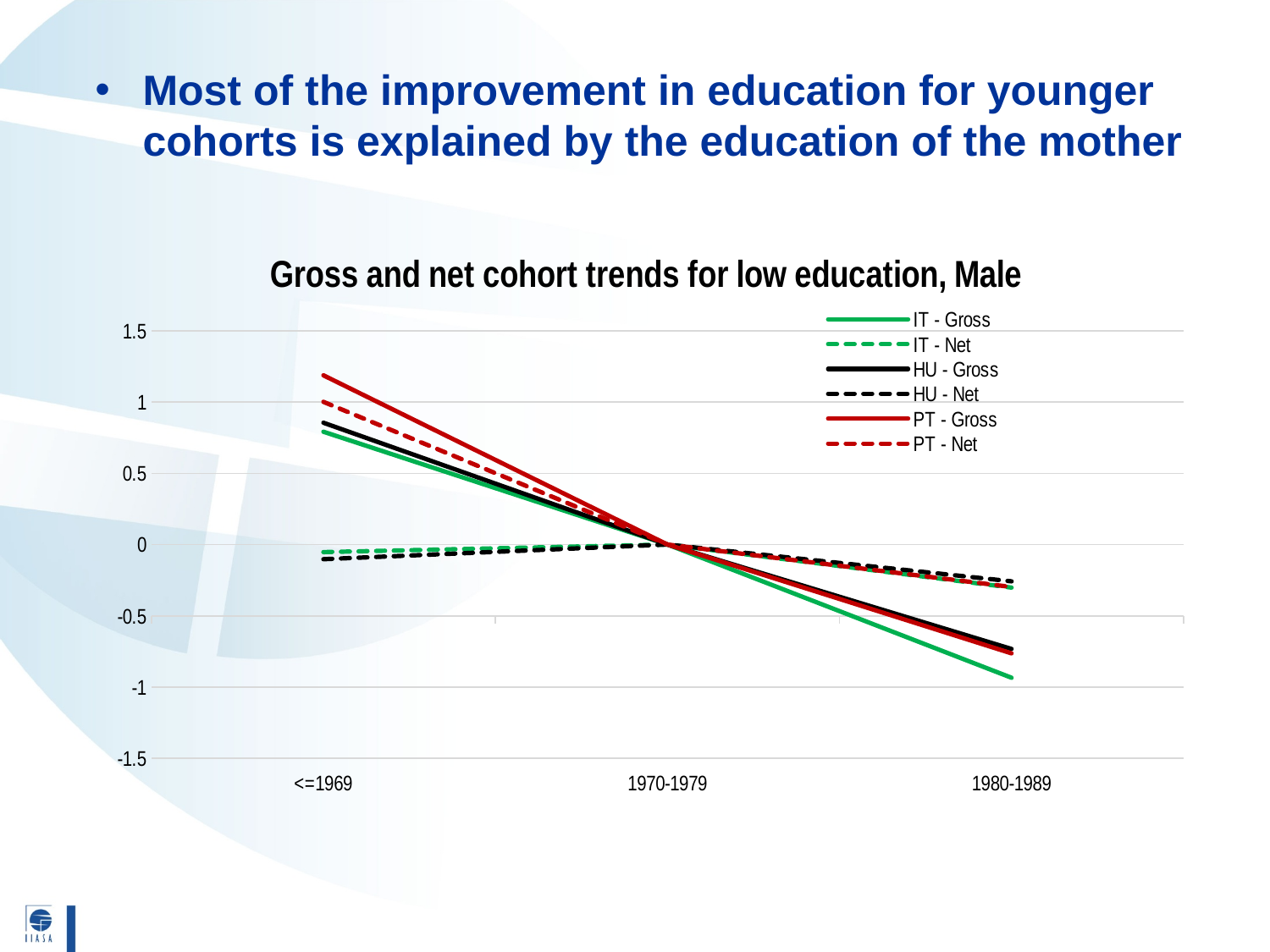
How many series does the legend list? 6 What is the title of the chart? Gross and net cohort trends for low education, Male Is the value for HU - Net at <=1969 greater or less than 0? less How many cohort categories are shown on the x axis? 3 Does the IT - Gross line rise or fall from <=1969 to 1980-1989? fall Which series has the lowest value for the 1980-1989 cohort? IT - Gross What type of chart is shown on the slide? line chart Which line style is used for the Net series in the legend? dashed Is the value for PT - Gross at <=1969 greater or less than 1? greater Which series has the highest value for the <=1969 cohort? PT - Gross Which is larger at <=1969, PT - Gross or IT - Gross? PT - Gross Is the value for IT - Gross at 1980-1989 greater or less than -0.5? less